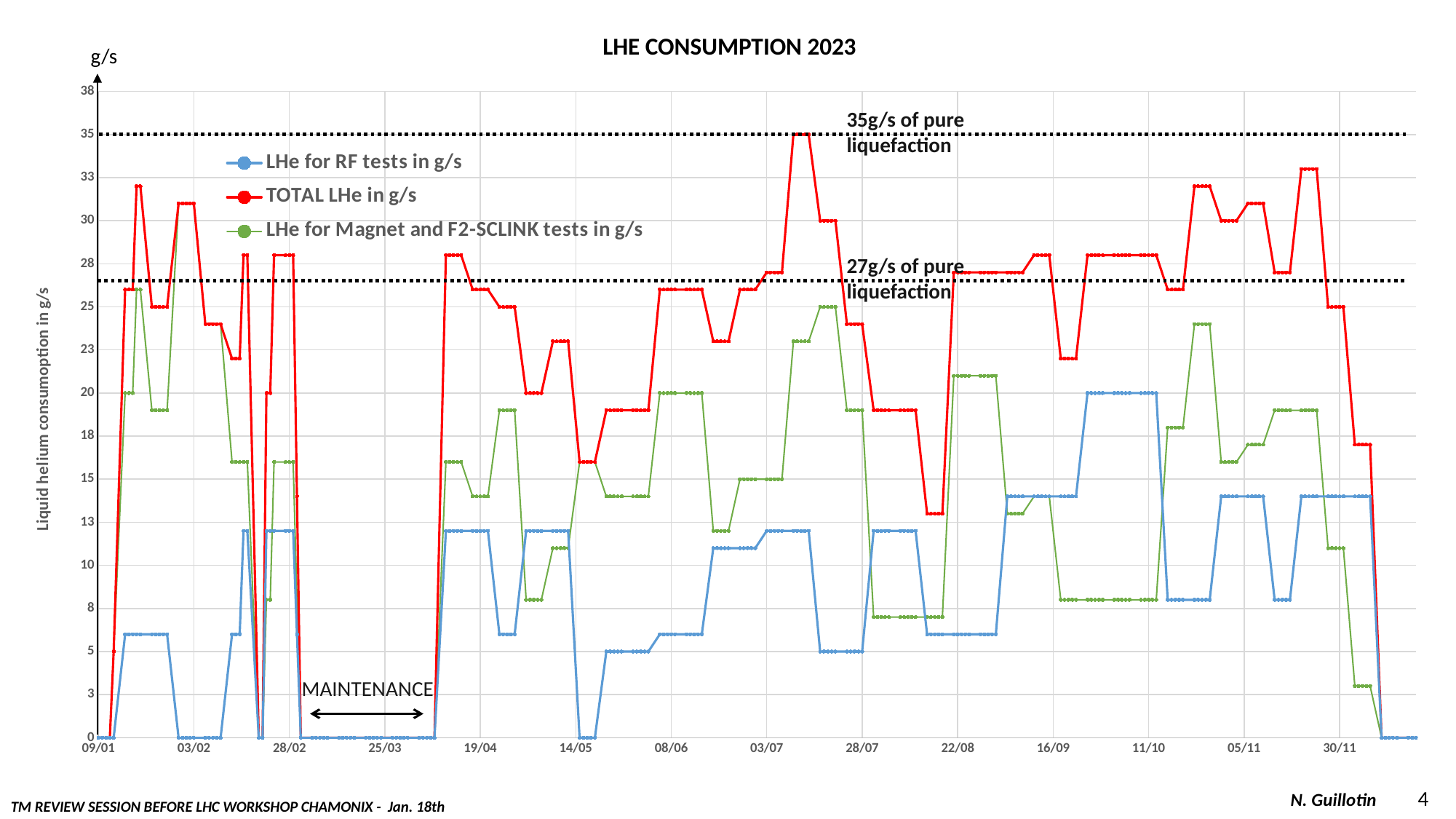
Is the value of LHe for RF tests at 11/10 greater or less than 15? greater Does TOTAL LHe rise or fall between 14/05 and 08/06? rise Is the value of TOTAL LHe at 11/10 greater or less than 25? greater Is the value of TOTAL LHe at 19/04 greater or less than 20? greater What value do all three series have during the MAINTENANCE period? 0 What label is written between 28/02 and 25/03 on the chart? MAINTENANCE At 08/06, which is higher: LHe for RF tests or LHe for Magnet and F2-SCLINK tests? LHe for Magnet and F2-SCLINK tests What type of chart is shown on the slide? line chart What is the peak value reached by TOTAL LHe in g/s? 35 How many series does the legend list? 3 What is the title of the chart? LHE CONSUMPTION 2023 Which series reaches the highest value on the chart? TOTAL LHe in g/s